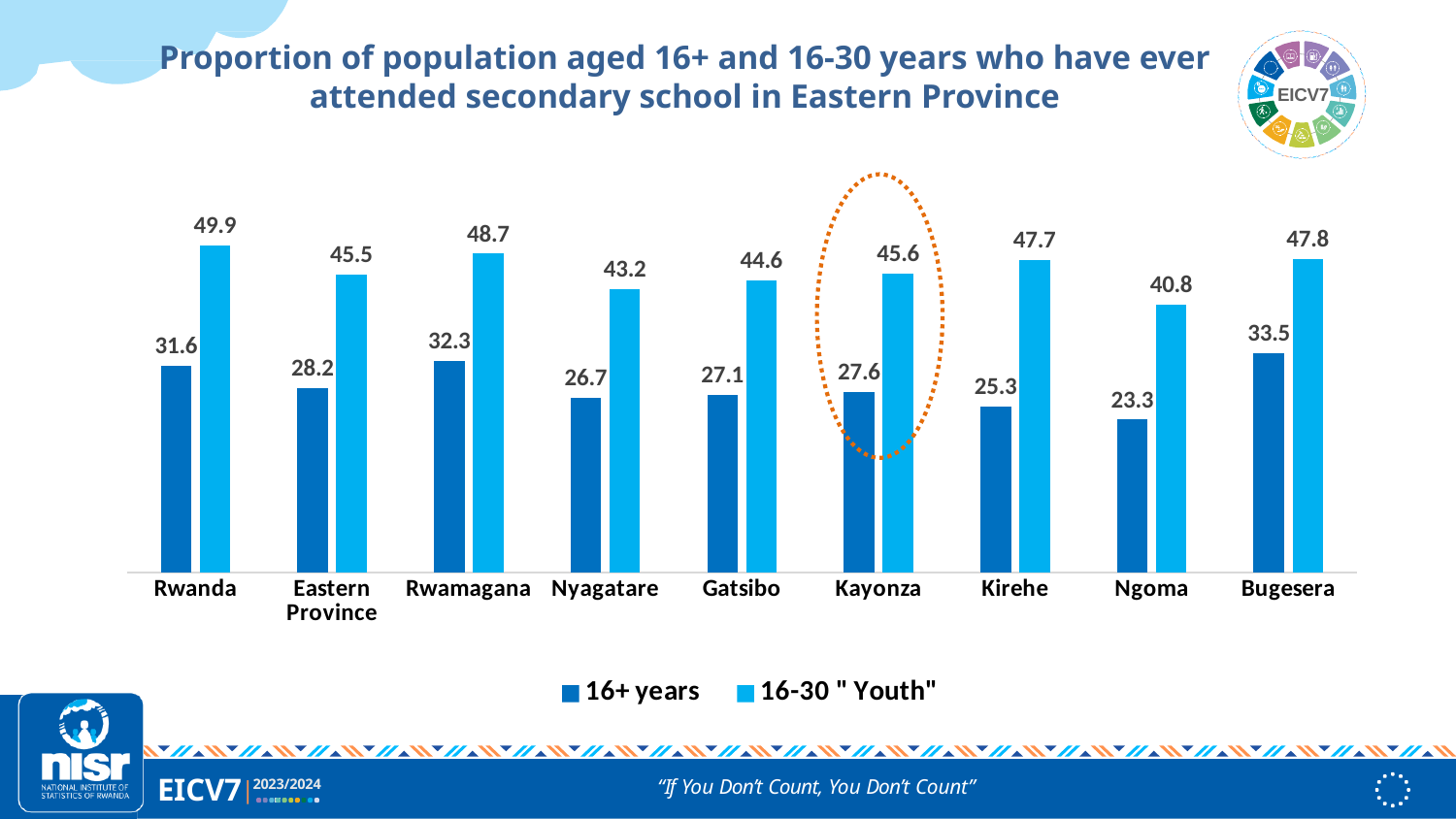
How many series does the legend list? 2 What is the value for Ngoma in the 16+ years series? 23.3 Which category has the highest value in the 16-30 "Youth" series? Rwanda How many categories are shown on the x axis? 9 Which category has the highest value in the 16+ years series? Bugesera What is the value for Rwanda in the 16-30 "Youth" series? 49.9 What is the value for Kayonza in the 16-30 "Youth" series? 45.6 Which category has the lowest value in the 16-30 "Youth" series? Ngoma Which is larger: the 16+ years value for Rwamagana or the 16+ years value for Nyagatare? Rwamagana What kind of chart is shown on the slide? Bar chart Which category is highlighted with a dotted orange circle? Kayonza What is the difference between the 16-30 "Youth" value and the 16+ years value for Kayonza? 18.0